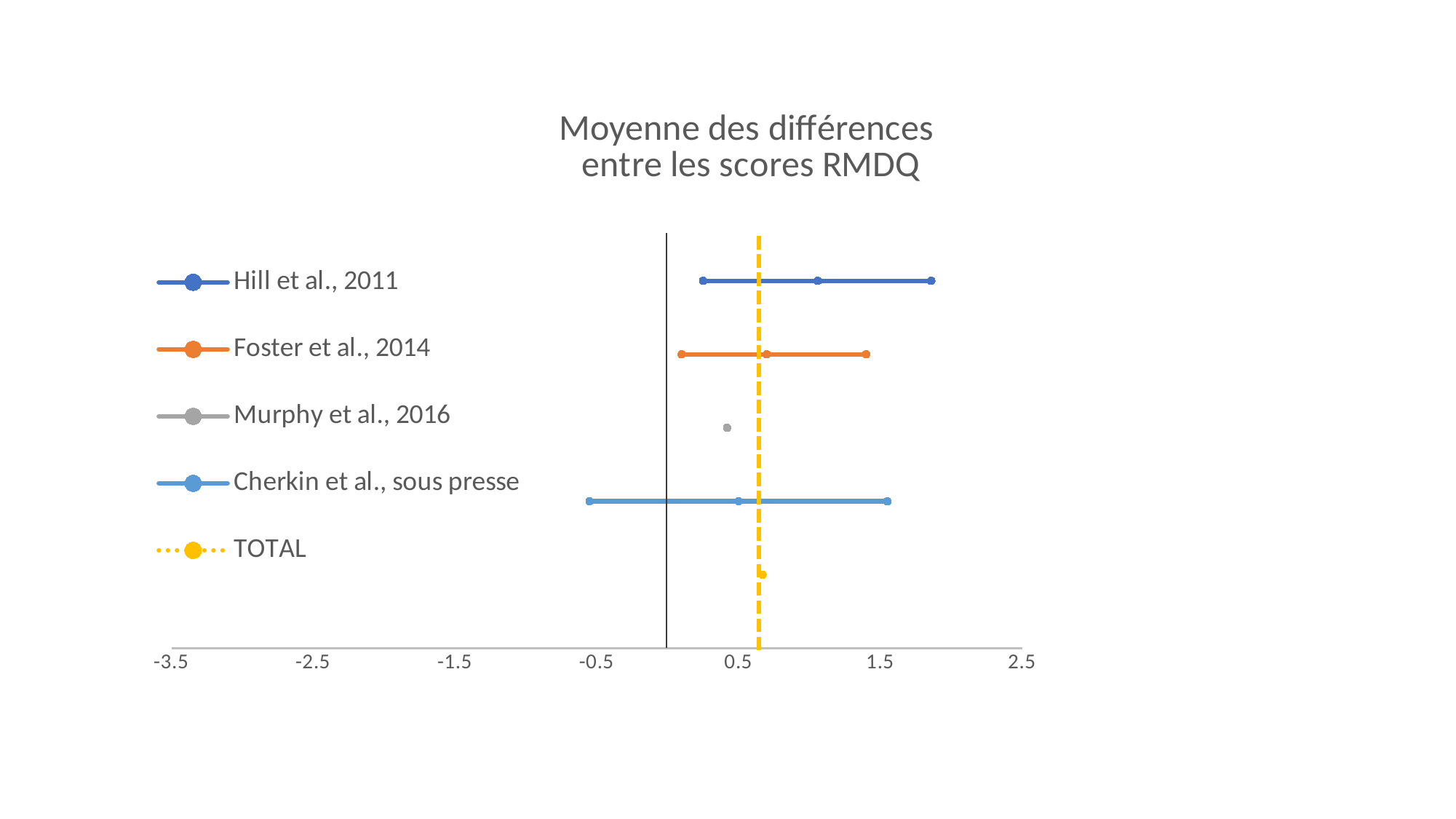
Which series is drawn with a dotted yellow line in the legend? TOTAL How many series does the legend list? 5 Which study's interval extends furthest to the left (below zero)? Cherkin et al., sous presse What is the lowest value shown on the horizontal axis? -3.5 Is the central estimate for Hill et al., 2011 greater or less than 0.5? greater Which has the larger central estimate, Hill et al., 2011 or Foster et al., 2014? Hill et al., 2011 Is the lower end of the interval for Foster et al., 2014 greater or less than -0.5? greater Is the upper end of the interval for Hill et al., 2011 greater or less than 1.5? greater What is the title of the chart? Moyenne des différences entre les scores RMDQ Which study has the highest central estimate? Hill et al., 2011